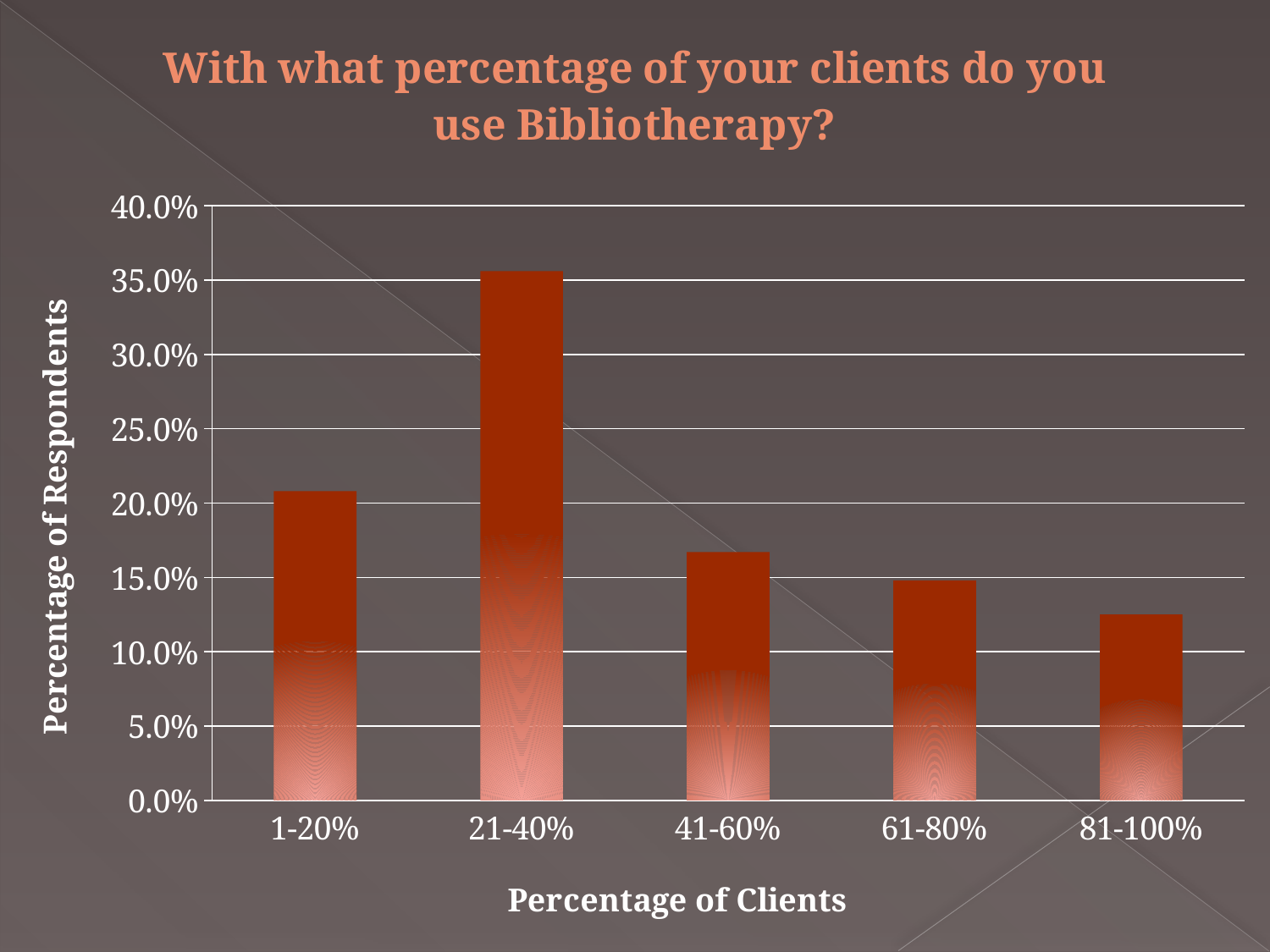
Is the value for 61-80% greater or less than 10.0%? greater Is the value for 41-60% greater or less than 15.0%? greater Is the value for 81-100% greater or less than 15.0%? less From the 21-40% category onward, do the values rise or fall along the x axis? fall What kind of chart is shown on the slide? bar chart Which category has the lowest percentage of respondents? 81-100% Which is larger, the value for 1-20% or the value for 41-60%? 1-20% Which category has the highest percentage of respondents? 21-40% What is the label of the y axis? Percentage of Respondents How many categories are shown on the x axis? 5